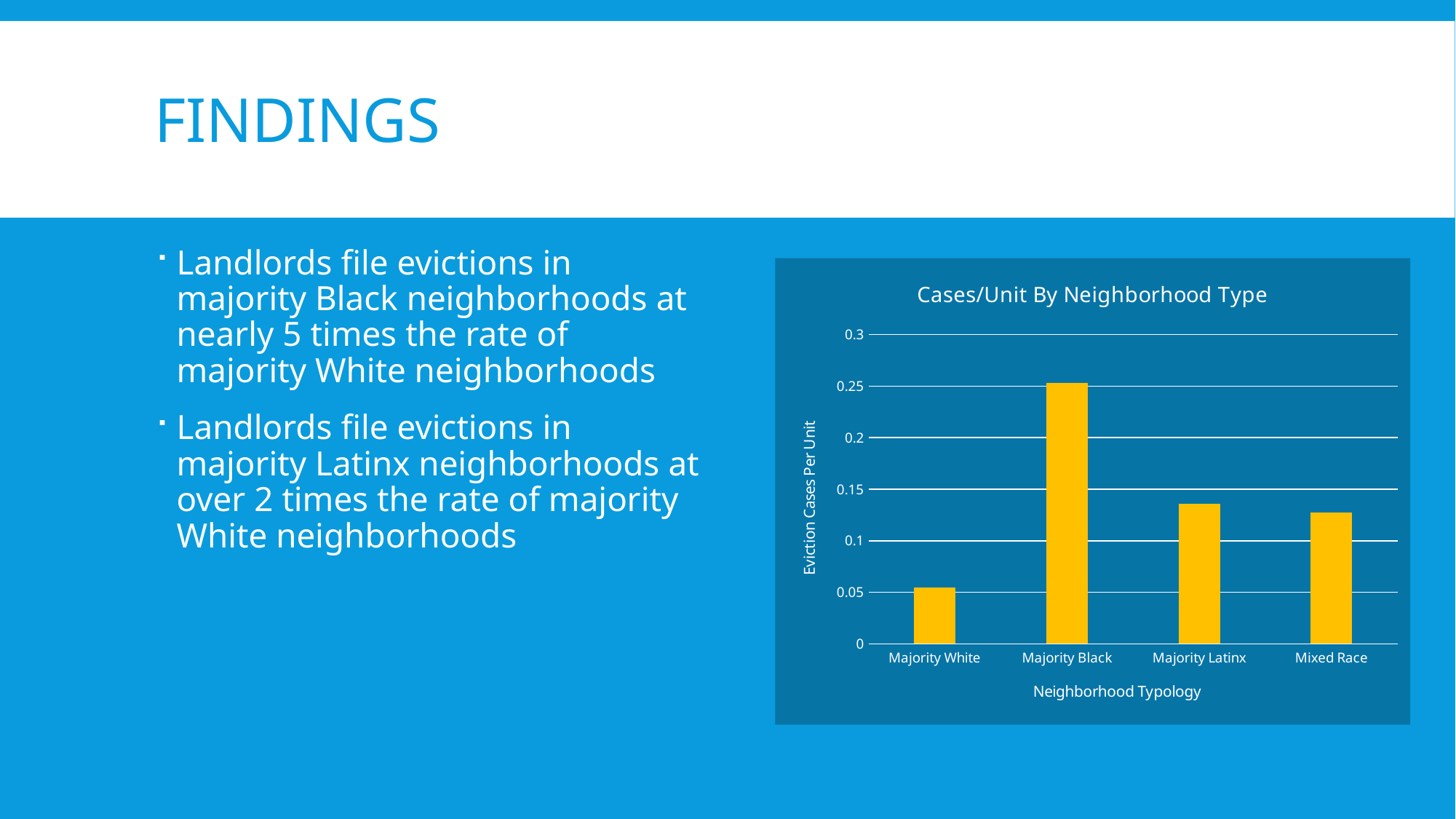
Is the value for Majority White greater or less than 0.1? less Which neighborhood type has the lowest eviction cases per unit? Majority White Is the value for Mixed Race greater or less than 0.15? less Is the value for Majority Black greater or less than 0.2? greater Which has more eviction cases per unit, Majority White or Mixed Race? Mixed Race What is the label of the vertical axis of the chart? Eviction Cases Per Unit What is the title of the chart? Cases/Unit By Neighborhood Type Which has more eviction cases per unit, Majority Black or Majority Latinx? Majority Black What kind of chart is shown on the slide? bar chart How many neighborhood types are plotted in the chart? 4 Which neighborhood type has the highest eviction cases per unit? Majority Black